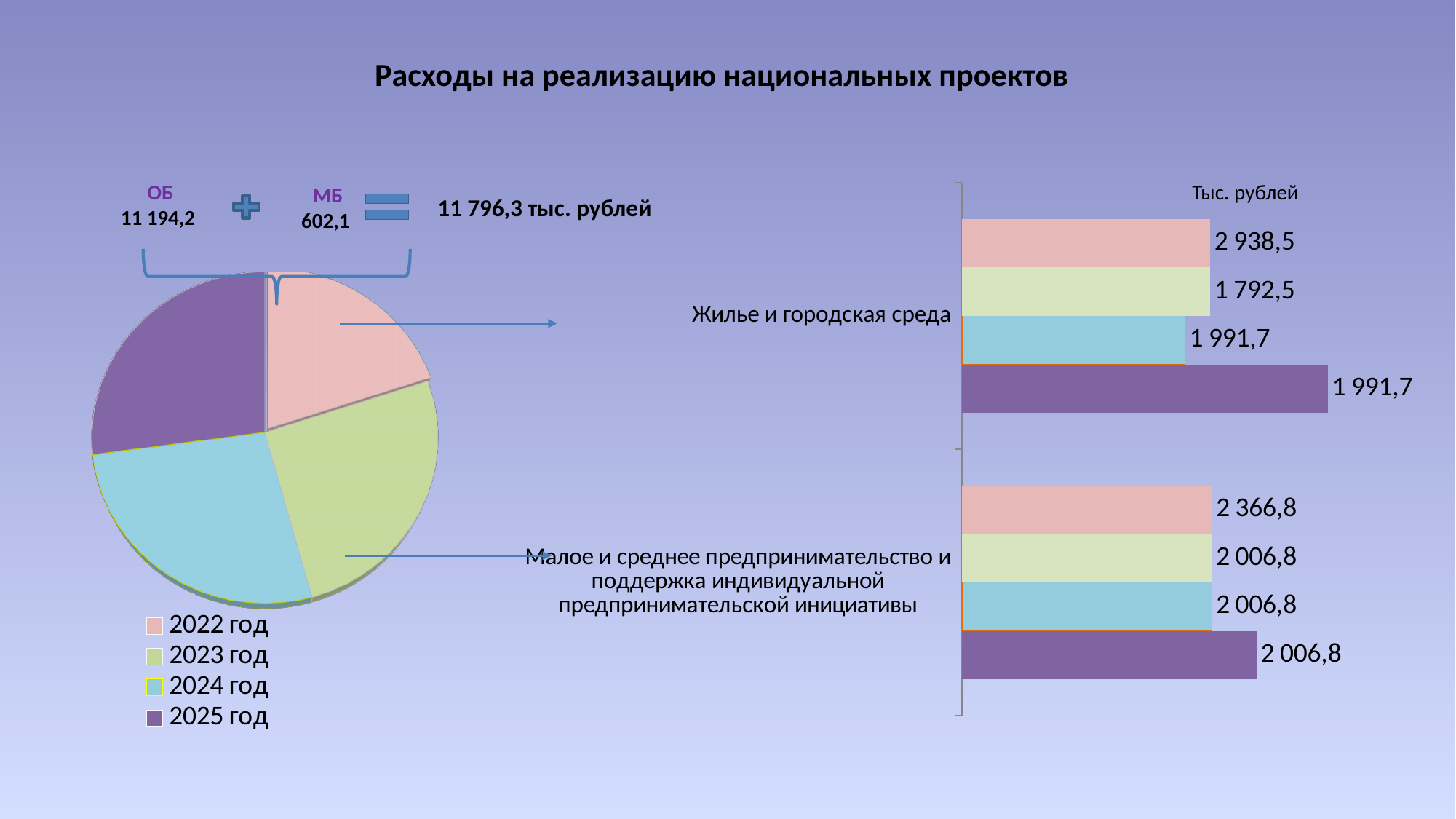
In the pie chart, which year has the smallest slice? 2022 год In the bar chart, what is the value of the 2022 год bar for Жилье и городская среда? 2 938,5 In the bar chart, what is the value of the 2025 год bar for Малое и среднее предпринимательство и поддержка индивидуальной предпринимательской инициативы? 2 006,8 How many entries does the legend of the pie chart list? 4 In the bar chart, which is larger for 2022 год: Жилье и городская среда or Малое и среднее предпринимательство? Жилье и городская среда In the bar chart, what is the value of the 2023 год bar for Жилье и городская среда? 1 792,5 In the bar chart, what is the value of the 2022 год bar for Малое и среднее предпринимательство и поддержка индивидуальной предпринимательской инициативы? 2 366,8 In the bar chart, what is the difference between the 2022 год and 2023 год values for Жилье и городская среда? 1 146,0 What kind of chart is on the left side of the slide? pie chart In the bar chart, which year has the lowest value for Жилье и городская среда? 2023 год In the bar chart, which year has the highest value for Жилье и городская среда? 2022 год What kind of chart is on the right side of the slide? bar chart